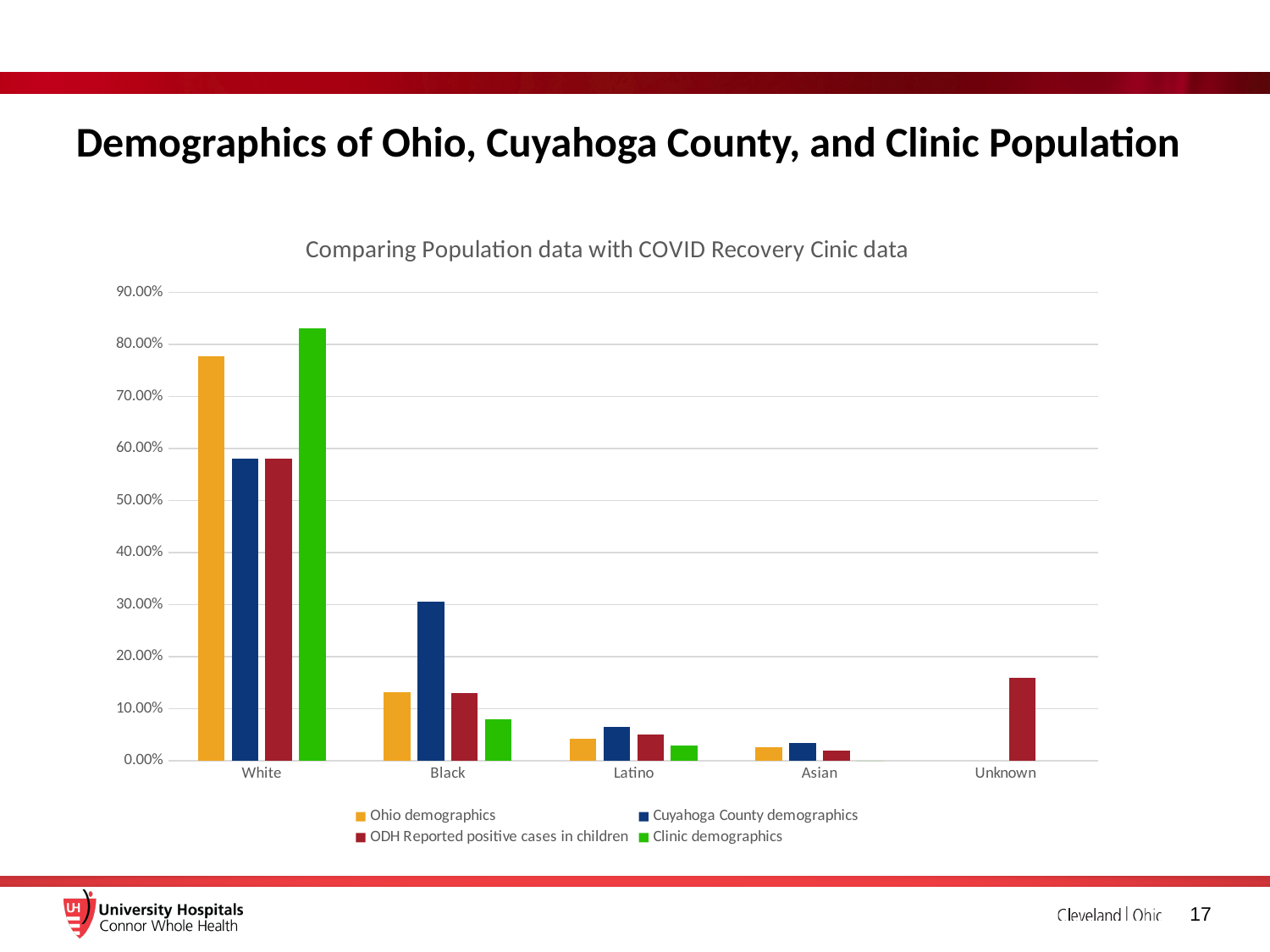
For the White category, which is larger: Clinic demographics or Ohio demographics? Clinic demographics For the Black category, which is larger: Ohio demographics or Cuyahoga County demographics? Cuyahoga County demographics What is the title of the chart? Comparing Population data with COVID Recovery Cinic data Which series has the highest value for the Black category? Cuyahoga County demographics How many series does the chart's legend list? 4 Is the Clinic demographics value for White greater or less than 80.00%? greater What kind of chart is shown on the slide? bar chart Is the Cuyahoga County demographics value for Black greater or less than 20.00%? greater How many categories are shown on the x axis of the chart? 5 Is the Ohio demographics value for White greater or less than 70.00%? greater Which category has the highest Clinic demographics value? White